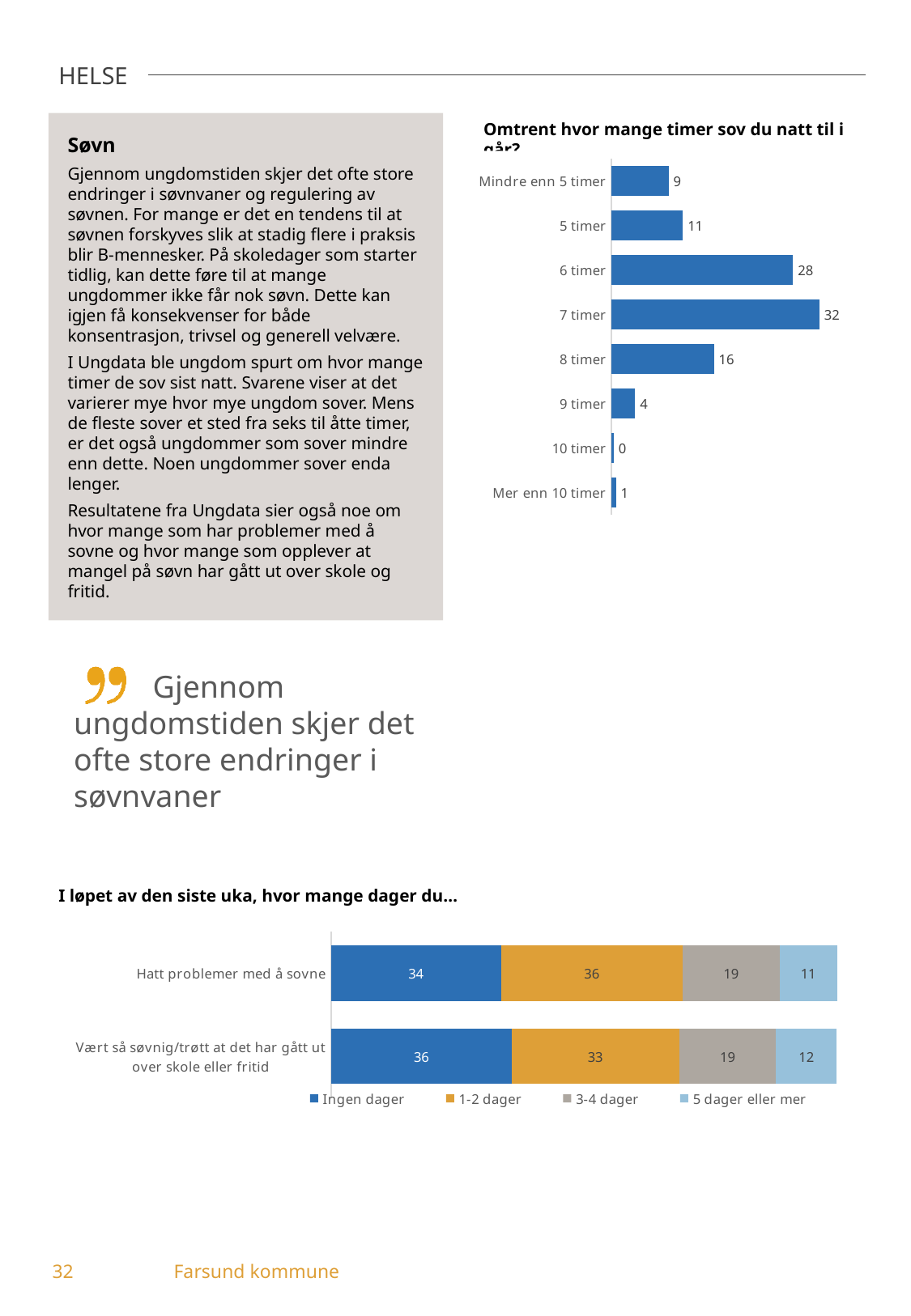
In the top-right chart about hours of sleep last night, what is the value for "7 timer"? 32 What kind of chart is the top-right chart about hours of sleep last night? Bar chart In the top-right chart about hours of sleep last night, which is larger: the value for "5 timer" or "9 timer"? 5 timer In the top-right chart about hours of sleep last night, how many categories are shown? 8 In the bottom chart "I løpet av den siste uka, hvor mange dager du…", which legend entry is shown in orange? 1-2 dager In the bottom chart "I løpet av den siste uka, hvor mange dager du…", what is the total of the "Hatt problemer med å sovne" bar? 100 In the bottom chart "I løpet av den siste uka, hvor mange dager du…", how many series does the legend list? 4 In the top-right chart about hours of sleep last night, which category has the lowest value? 10 timer In the bottom chart "I løpet av den siste uka, hvor mange dager du…", what is the value for "5 dager eller mer" in the "Vært så søvnig/trøtt at det har gått ut over skole eller fritid" bar? 12 In the bottom chart "I løpet av den siste uka, hvor mange dager du…", what is the value for "1-2 dager" in the "Hatt problemer med å sovne" bar? 36 In the top-right chart about hours of sleep last night, which category has the highest value? 7 timer In the top-right chart about hours of sleep last night, what is the difference between the values for "6 timer" and "8 timer"? 12